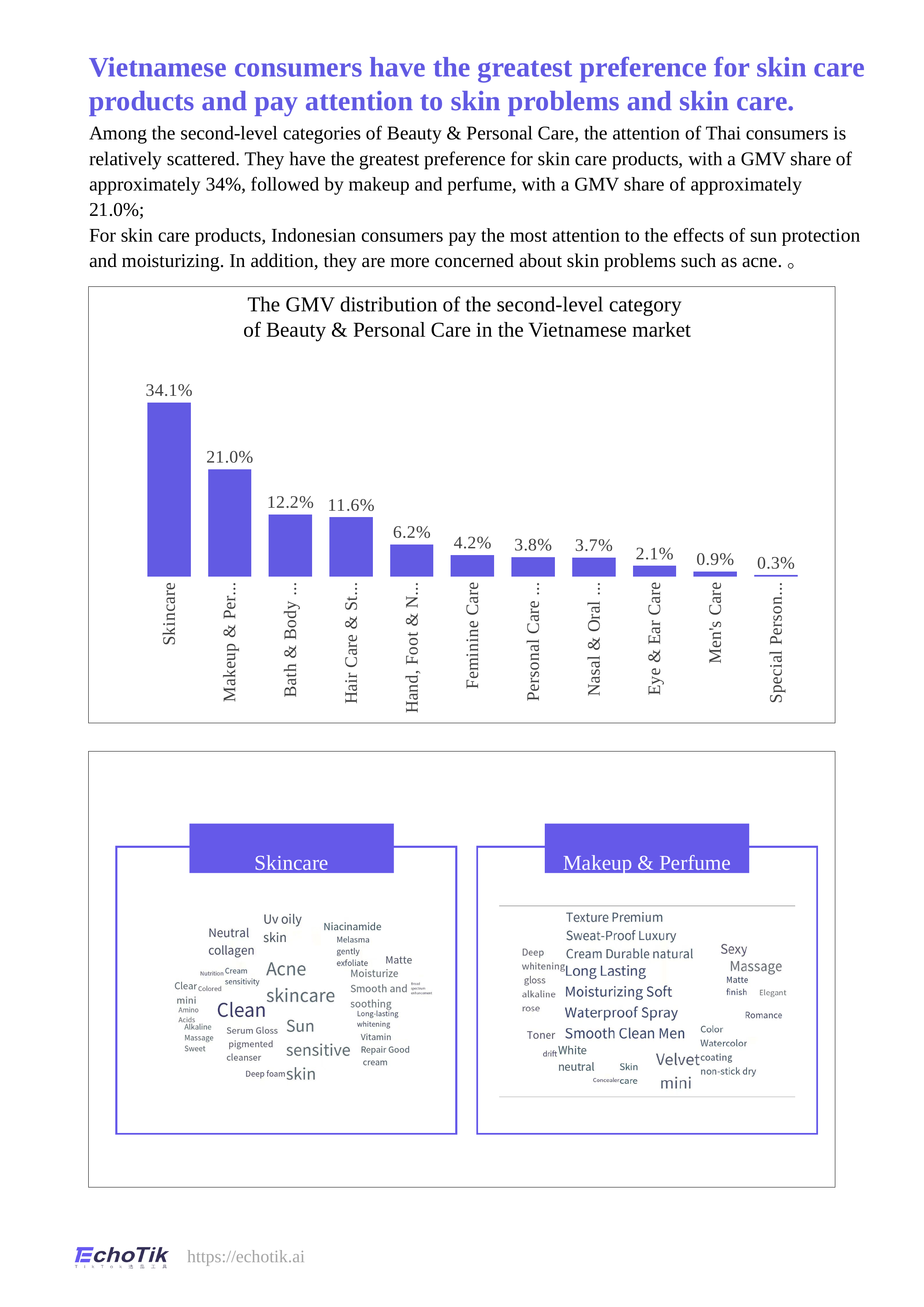
Which category has the highest GMV share? Skincare What kind of chart is used to show the GMV distribution? Bar chart What is the GMV share for Skincare? 34.1% What is the GMV share for Men's Care? 0.9% What is the difference in GMV share between Skincare and Feminine Care? 29.9% Which has a larger GMV share, Feminine Care or Men's Care? Feminine Care What is the difference in GMV share between Eye & Ear Care and Men's Care? 1.2% What is the GMV share for Feminine Care? 4.2% What is the GMV share for Eye & Ear Care? 2.1% Which category has the lowest GMV share? Special Person... Do the GMV share values rise or fall from left to right across the categories? Fall How many categories are shown in the bar chart? 11